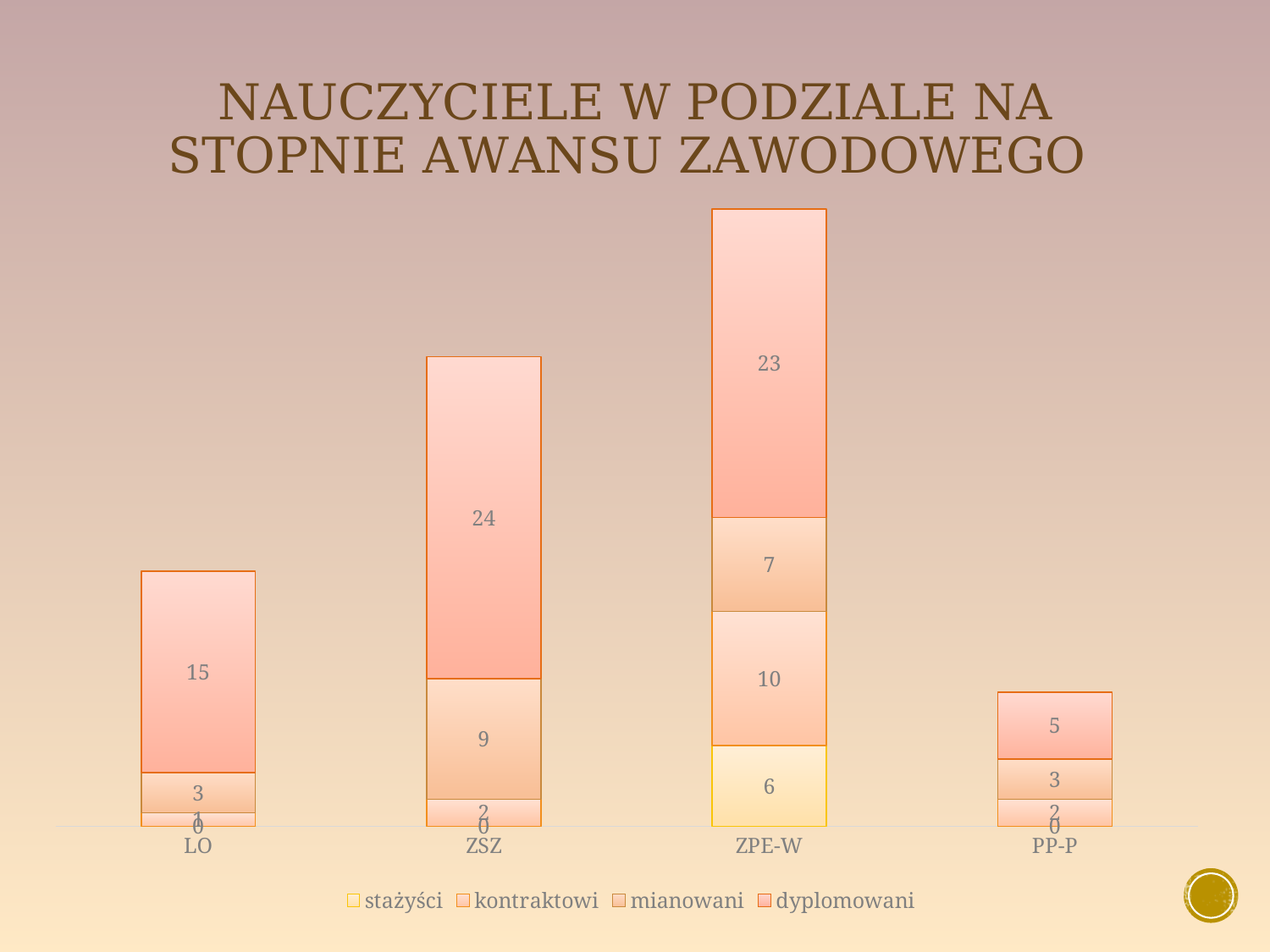
Which category has the highest value for dyplomowani? ZSZ How many categories are shown on the x axis? 4 What kind of chart is shown on the slide? stacked bar chart What is the value for mianowani in the ZSZ bar? 9 Which category has the shortest stacked bar overall? PP-P Which category has the tallest stacked bar overall? ZPE-W What is the value for kontraktowi in the ZPE-W bar? 10 How many series does the legend list? 4 What is the total of the stacked bar for ZPE-W? 46 What is the value for dyplomowani in the ZSZ bar? 24 What is the difference between the dyplomowani value for ZPE-W and the dyplomowani value for LO? 8 What is the value for stażyści in the ZPE-W bar? 6